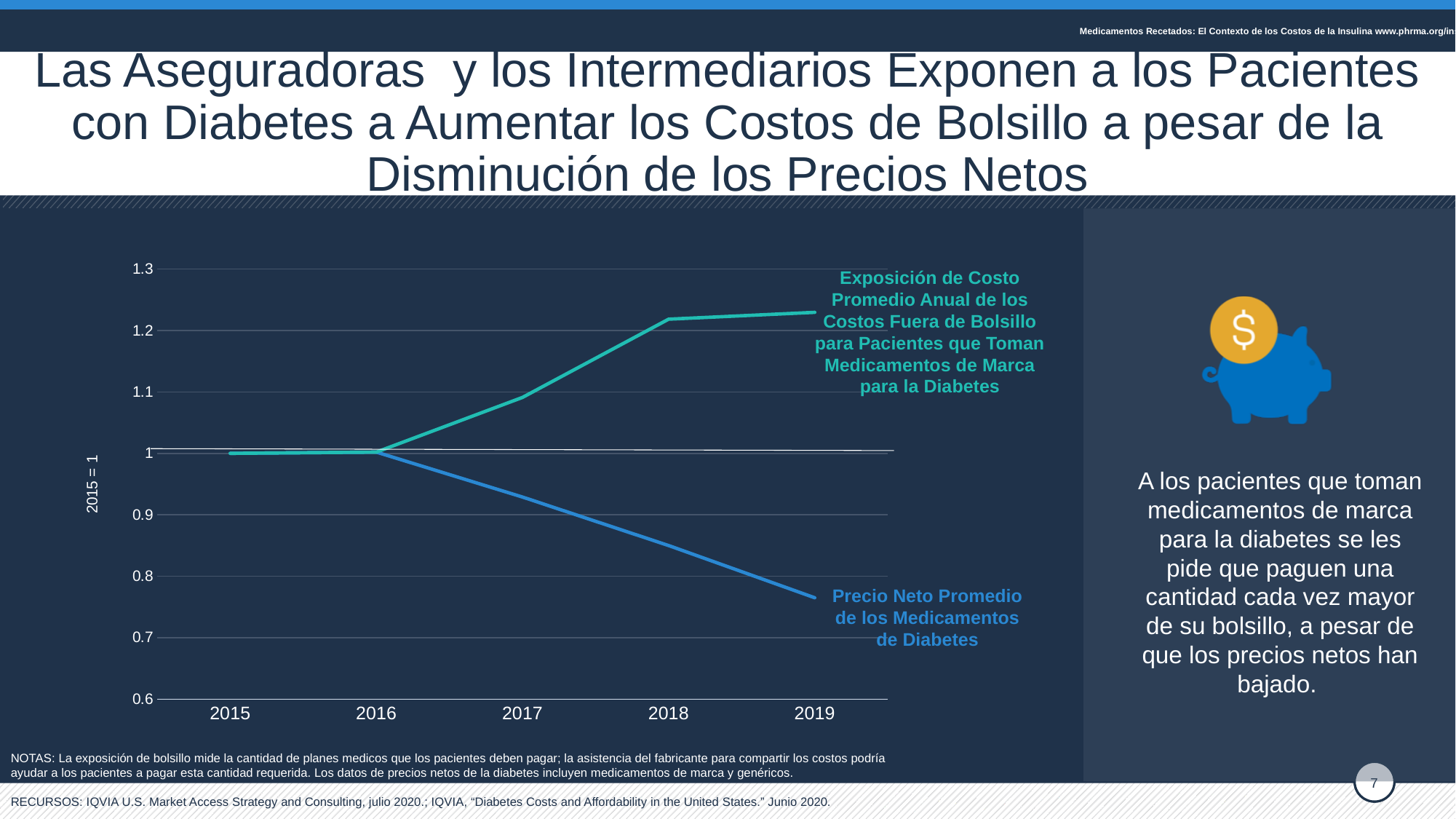
What is the value of both series in 2015, the base year of the index? 1 In 2019, which series has the higher value: 'Exposición de Costo Promedio Anual de los Costos Fuera de Bolsillo' or 'Precio Neto Promedio de los Medicamentos de Diabetes'? Exposición de Costo Promedio Anual de los Costos Fuera de Bolsillo How many years are plotted along the x axis of the chart? 5 What does the y-axis label of the chart say? 2015 = 1 Does the 'Precio Neto Promedio de los Medicamentos de Diabetes' line rise or fall from 2015 to 2019? fall Is the 2019 value for 'Precio Neto Promedio de los Medicamentos de Diabetes' greater or less than 0.8? less What kind of chart is shown on the slide? line chart How many data series are plotted in the chart? 2 Does the 'Exposición de Costo Promedio Anual de los Costos Fuera de Bolsillo' line rise or fall from 2015 to 2019? rise Is the 2017 value for 'Precio Neto Promedio de los Medicamentos de Diabetes' greater or less than 1? less Is the 2019 value for 'Exposición de Costo Promedio Anual de los Costos Fuera de Bolsillo' greater or less than 1.2? greater In which year does the 'Precio Neto Promedio de los Medicamentos de Diabetes' line reach its lowest value? 2019